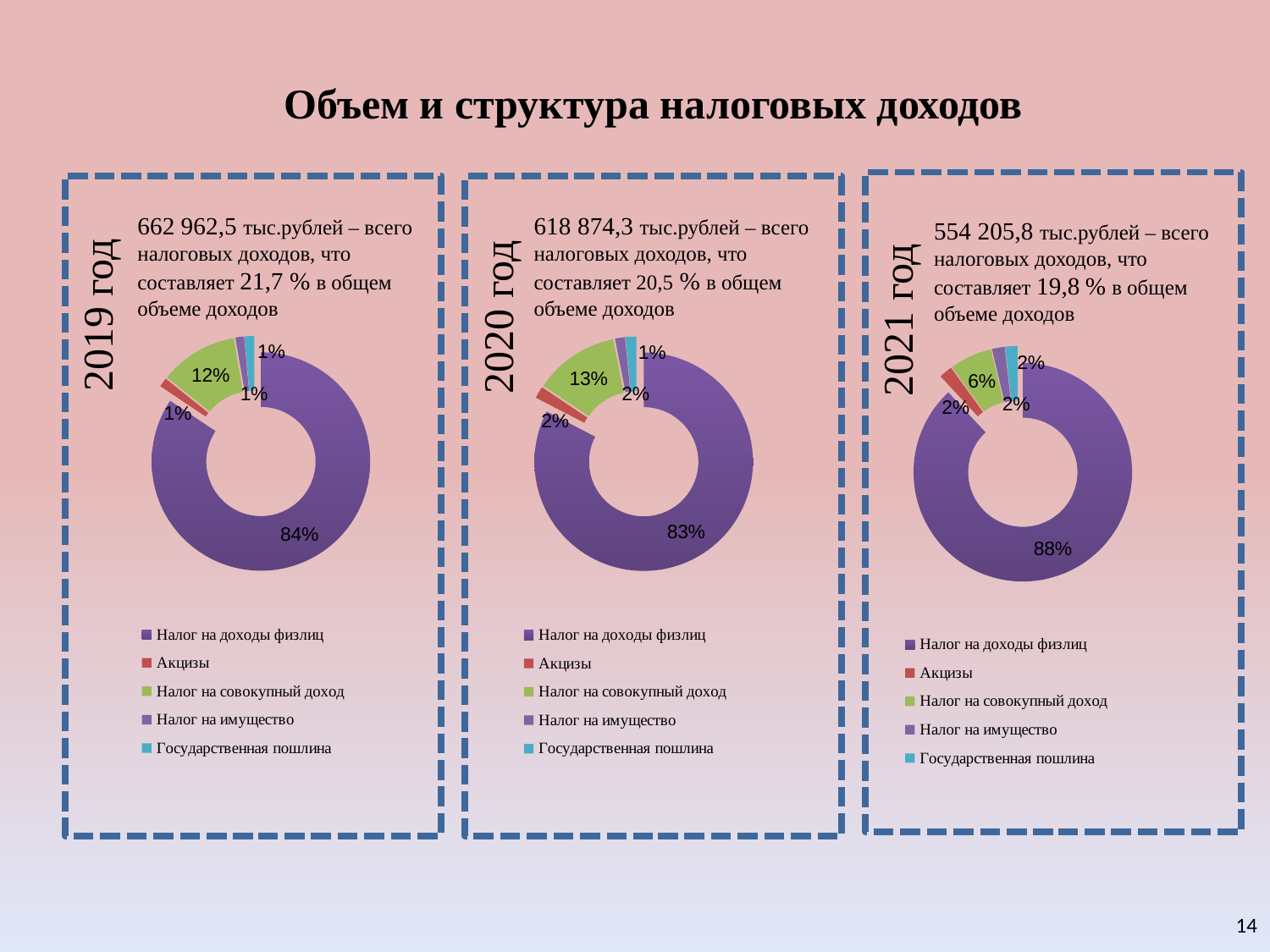
In the 2020 chart, which category has the largest share? Налог на доходы физлиц In the 2021 chart, what share does Налог на совокупный доход have? 6% In the 2020 chart, what share does Налог на совокупный доход have? 13% In the 2020 chart, which category has the smallest share? Налог на имущество In the 2021 chart, which is larger: the share of Налог на совокупный доход or the share of Акцизы? Налог на совокупный доход In the 2019 chart, what share does Налог на доходы физлиц have? 84% In the 2021 chart, what share does Налог на доходы физлиц have? 88% What type of chart is used for the 2020 data? Doughnut (pie) chart How many entries does the legend of the 2021 chart list? 5 What is the title of the slide containing the three charts? Объем и структура налоговых доходов How many categories does the 2019 chart show? 5 In the 2019 chart, what is the difference between the shares of Налог на доходы физлиц and Налог на совокупный доход? 72%